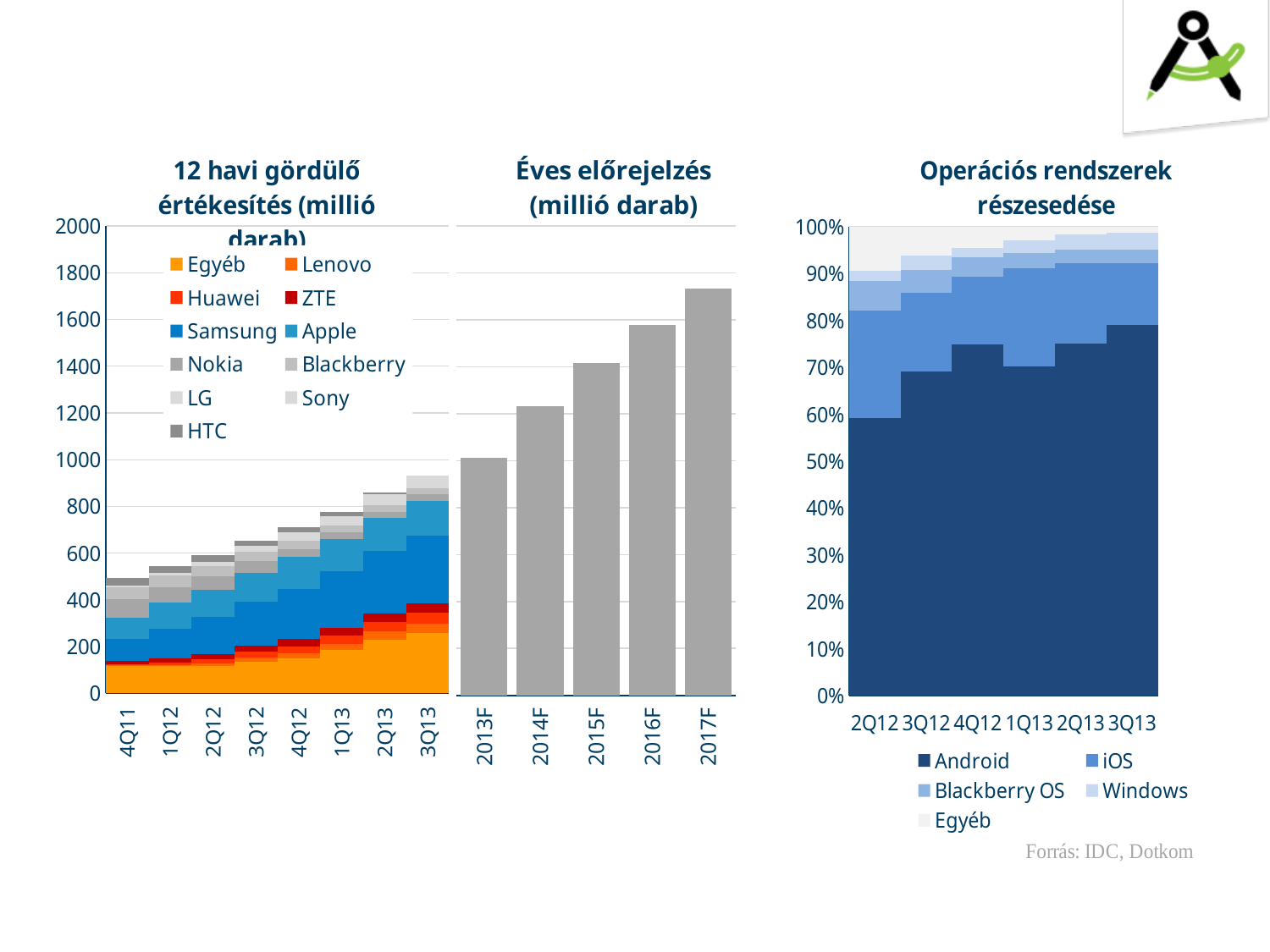
In the 'Operációs rendszerek részesedése' chart, which quarter has the highest Android share? 3Q13 In the 'Éves előrejelzés (millió darab)' chart, is the value for 2017F greater or less than 1600? greater In the 'Éves előrejelzés (millió darab)' chart, how many forecast years are shown? 5 What kind of chart is the 'Éves előrejelzés (millió darab)' chart? bar chart In the '12 havi gördülő értékesítés (millió darab)' chart, how many series does the legend list? 11 In the 'Éves előrejelzés (millió darab)' chart, do the values rise or fall from 2013F to 2017F? rise In the '12 havi gördülő értékesítés (millió darab)' chart, is the total stacked value for 3Q13 greater or less than 800? greater In the 'Operációs rendszerek részesedése' chart, how many series does the legend list? 5 In the 'Éves előrejelzés (millió darab)' chart, which year has the lowest value? 2013F In the 'Éves előrejelzés (millió darab)' chart, which year has the highest value? 2017F In the 'Operációs rendszerek részesedése' chart, is the Android share in 3Q13 greater or less than 70%? greater In the '12 havi gördülő értékesítés (millió darab)' chart, how many quarters are shown on the x axis? 8